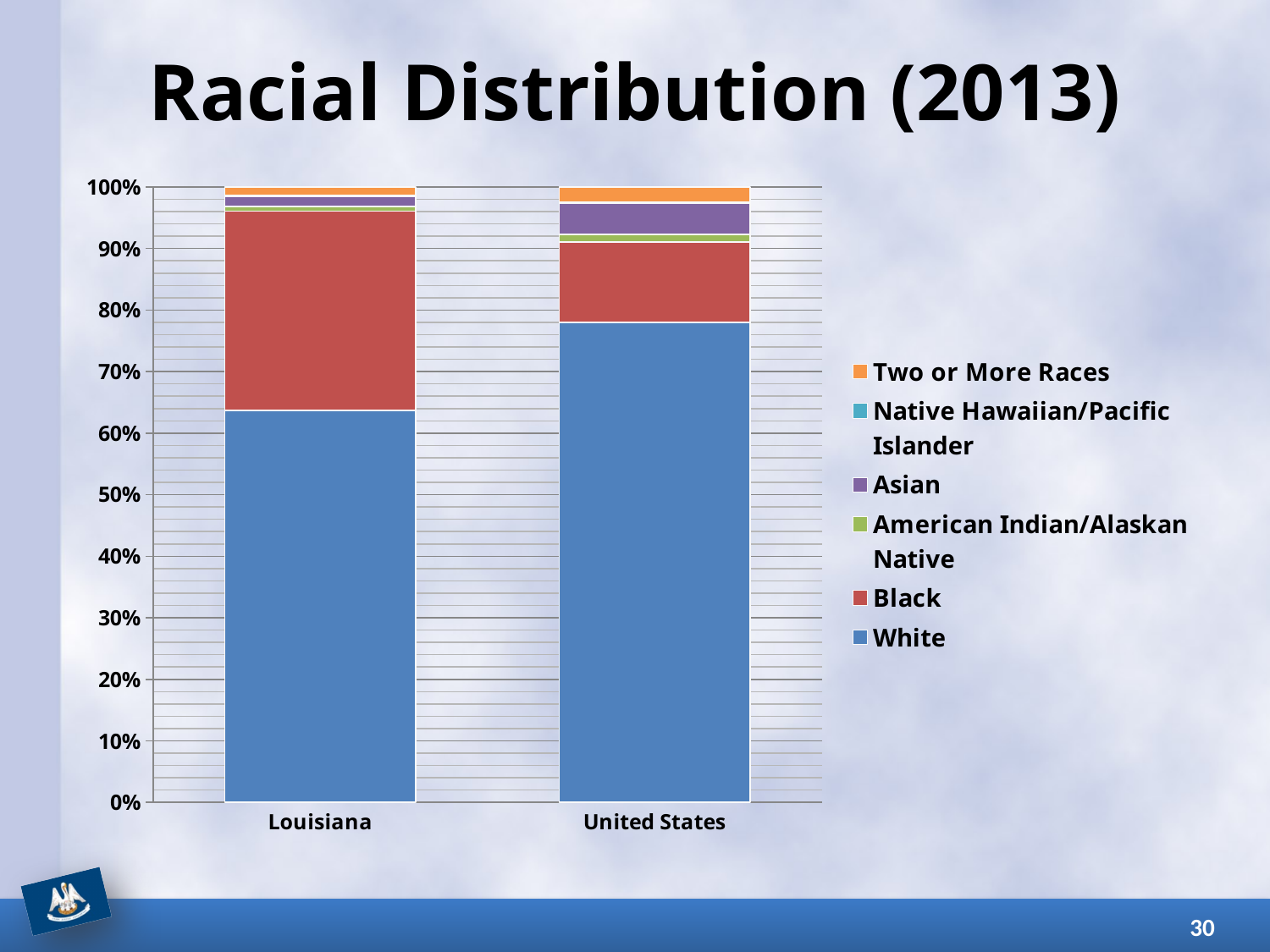
Is the White share for the United States greater or less than 80%? less Is the White share for the United States greater or less than 70%? greater Which colour represents the White series in the chart? Blue How many categories are shown on the x axis of the chart? 2 Which category has the larger White share, Louisiana or the United States? United States Is the White share for Louisiana greater or less than 70%? less What kind of chart is shown on the slide? Stacked bar chart How many series does the chart's legend list? 6 What is the title of the chart on the slide? Racial Distribution (2013) Which category has the larger Black share, Louisiana or the United States? Louisiana Which category has the larger Asian share, Louisiana or the United States? United States